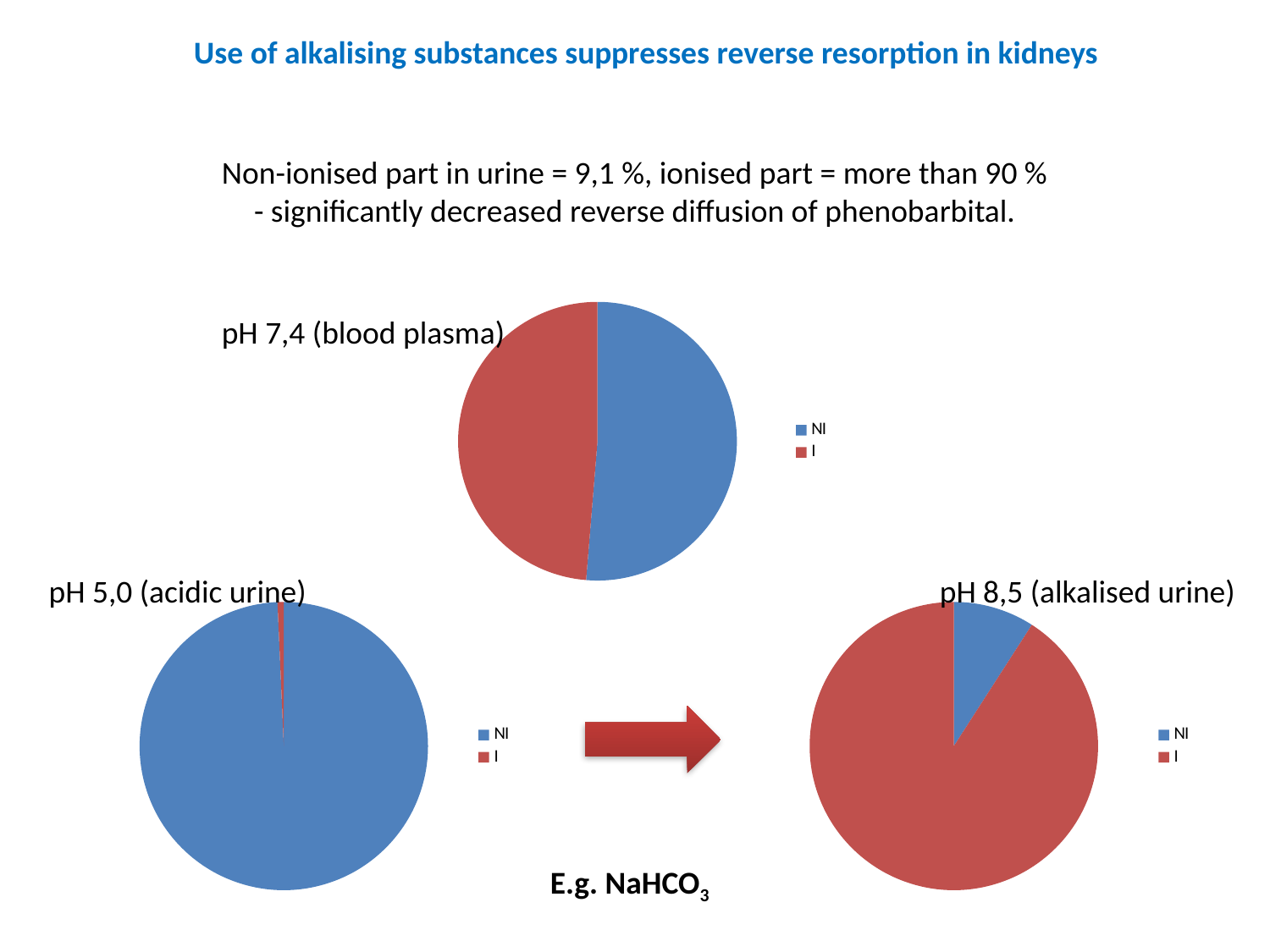
In the pH 8,5 (alkalised urine) chart, which category has the largest slice? I In the pH 5,0 (acidic urine) chart, which category has the smallest slice? I In the pH 5,0 (acidic urine) chart, which slice is larger, NI or I? NI In the pH 8,5 (alkalised urine) chart, which slice is larger, NI or I? I What colour represents the NI category in the pie charts? blue What kind of chart is the pH 5,0 (acidic urine) chart? pie chart How many pie charts are shown on the slide? 3 In the pH 8,5 (alkalised urine) chart, which category has the smallest slice? NI What are the two legend entries shown for the pH 7,4 (blood plasma) chart? NI and I How many entries does the legend of the pH 8,5 (alkalised urine) chart list? 2 How many slices does the pH 7,4 (blood plasma) pie chart have? 2 What kind of chart is the pH 7,4 (blood plasma) chart? pie chart